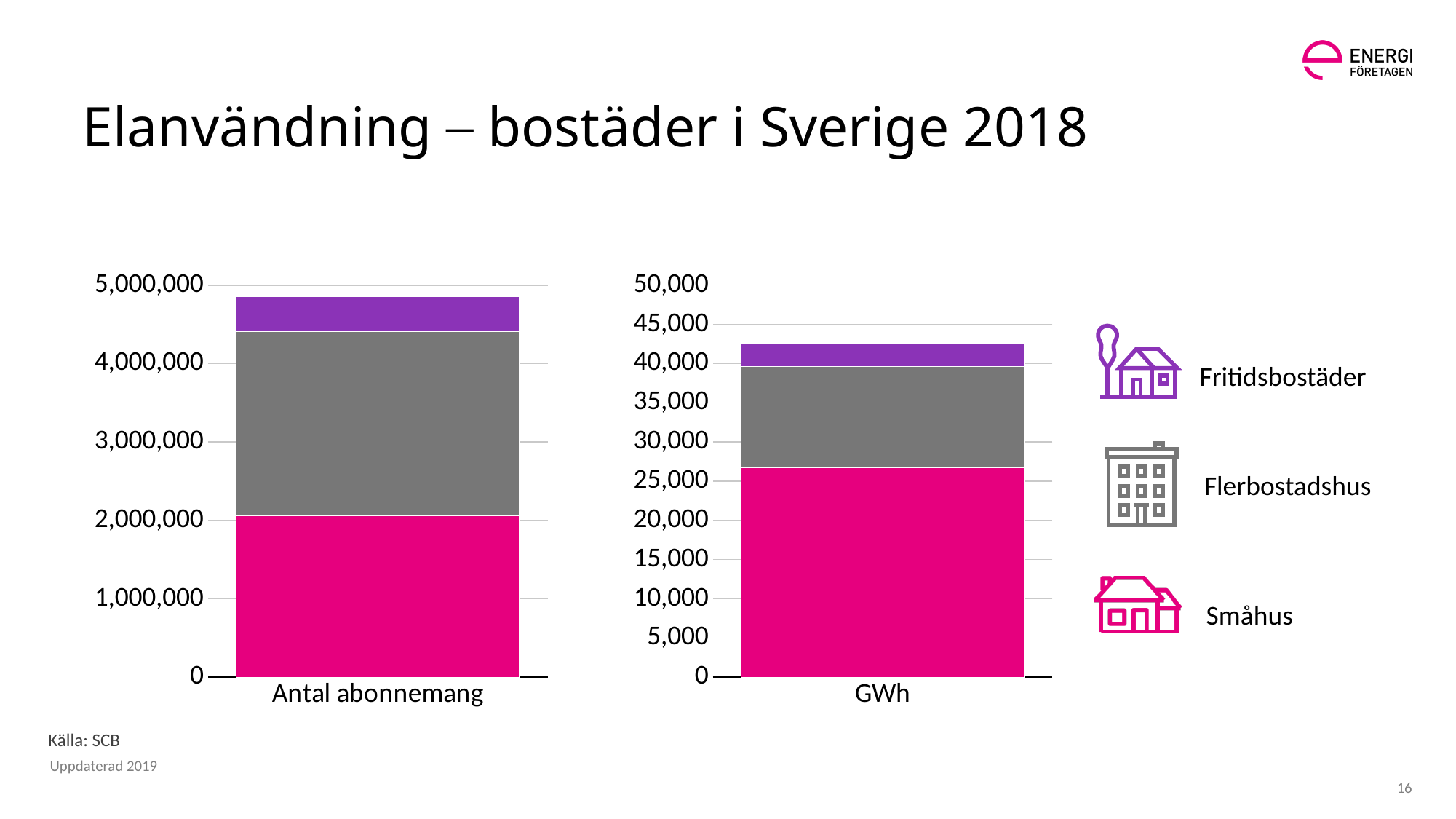
In the right chart (GWh), is the total height of the stacked bar greater or less than 45,000? less What kind of chart is the left chart, titled "Antal abonnemang"? Stacked bar chart In the right chart (GWh), which series has the largest segment? Småhus How many bars are plotted in the right chart, labelled "GWh"? 1 In the left chart (Antal abonnemang), is the total height of the stacked bar greater or less than 4,000,000? greater In the right chart (GWh), which series has the smallest segment? Fritidsbostäder How many series does the legend list for the charts? 3 In the right chart (GWh), which is larger, the Småhus segment or the Flerbostadshus segment? Småhus In the left chart (Antal abonnemang), which series has the smallest segment? Fritidsbostäder In the right chart (GWh), is the Småhus segment greater or less than 25,000? greater Which three series are listed in the legend? Fritidsbostäder, Flerbostadshus, Småhus